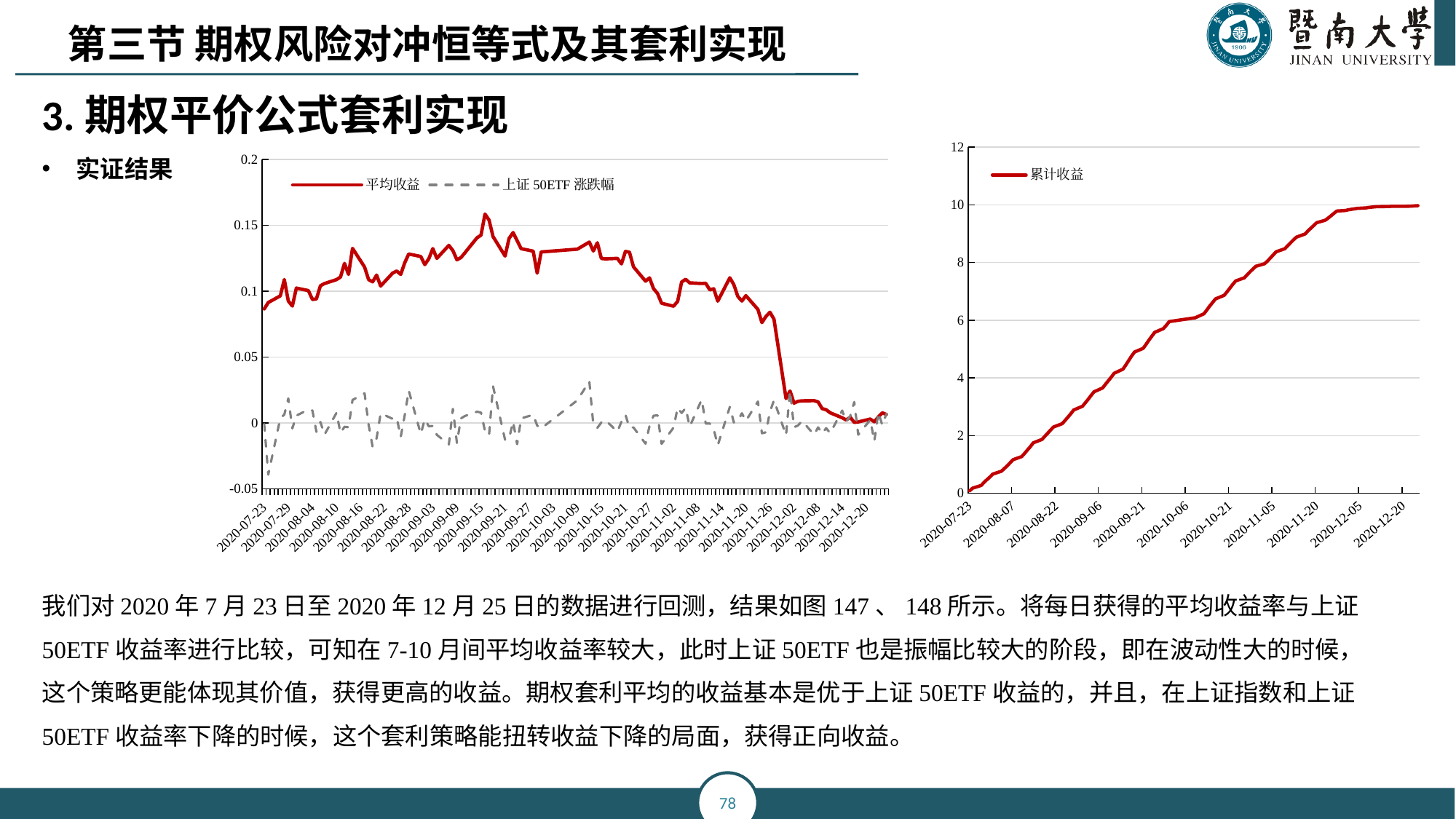
In the right chart, does 累计收益 rise or fall along the x axis? rise In the left chart, is the peak value of 平均收益 around 2020-09-15 greater or less than 0.15? greater In the left chart, is the value of 平均收益 at 2020-12-20 greater or less than 0.05? less What kind of chart is the left chart on the slide? line chart In the right chart, is the value of 累计收益 at 2020-11-20 greater or less than 8? greater In the left chart, which series is drawn with a dashed line? 上证 50ETF 涨跌幅 How many series does the legend of the left chart list? 2 What kind of chart is the right chart on the slide? line chart How many series does the legend of the right chart list? 1 In the right chart, what is the name of the series shown in the legend? 累计收益